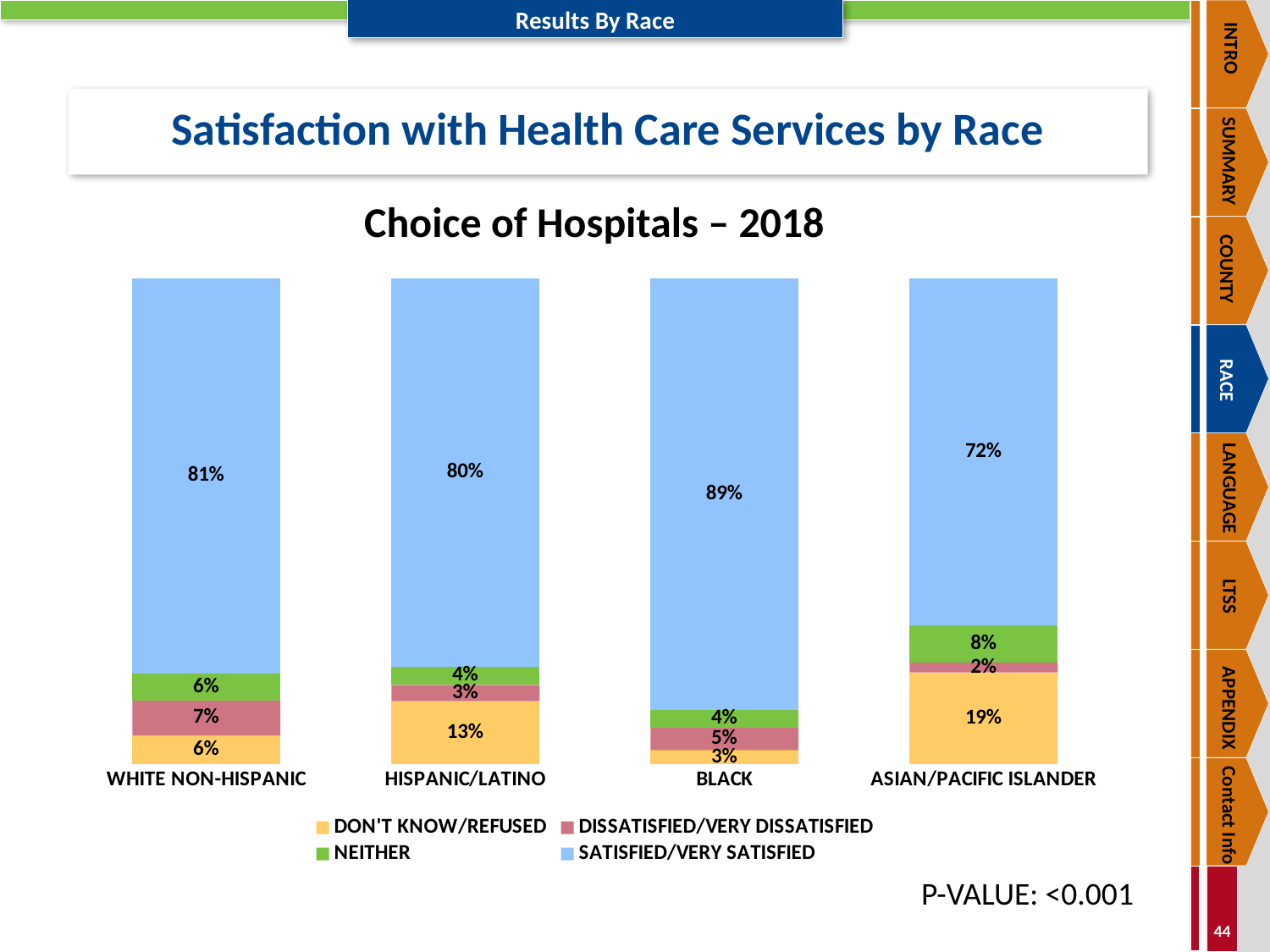
Which race group has the lowest Satisfied/Very Satisfied value? Asian/Pacific Islander What is the total of the stacked bar for White Non-Hispanic? 100% What is the Dissatisfied/Very Dissatisfied value for White Non-Hispanic? 7% What type of chart is shown on the slide? Stacked bar chart How many race groups are shown on the x axis? 4 What is the Neither value for Hispanic/Latino? 4% What is the Satisfied/Very Satisfied value for Black? 89% How many series does the legend list? 4 Which race group has the highest Satisfied/Very Satisfied value? Black Which is larger: the Don't Know/Refused value for Hispanic/Latino or for White Non-Hispanic? Hispanic/Latino What is the difference between the Satisfied/Very Satisfied values for Black and Asian/Pacific Islander? 17% What is the Don't Know/Refused value for Asian/Pacific Islander? 19%